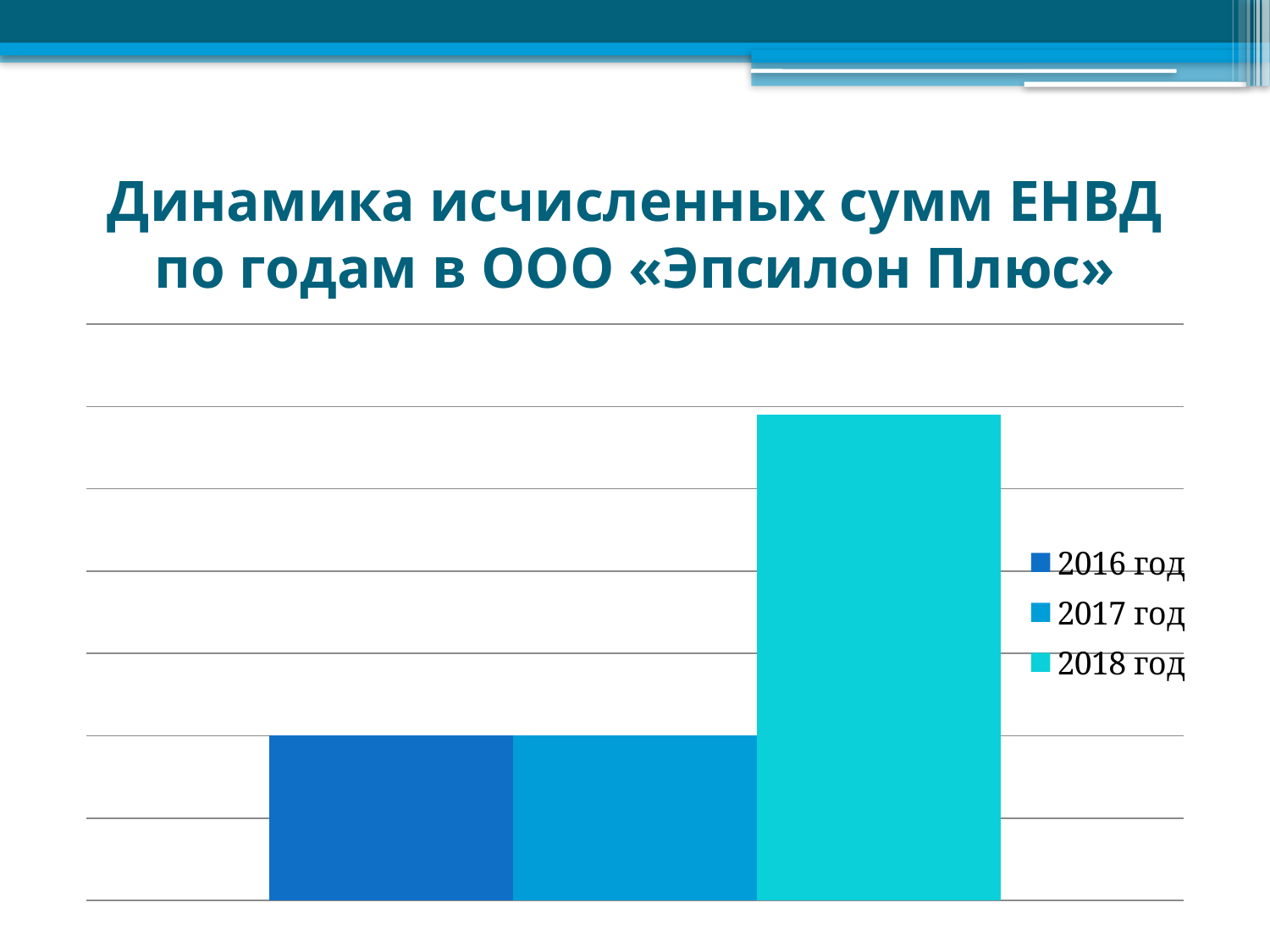
Which is larger, the value for 2017 год or the value for 2018 год? 2018 год How many bars are plotted in the chart? 3 What is the title of the slide containing the chart? Динамика исчисленных сумм ЕНВД по годам в ООО «Эпсилон Плюс» What kind of chart is shown on the slide? bar chart Do the values rise or fall from 2016 to 2018? rise How many series does the legend list? 3 Which is larger, the value for 2018 год or the value for 2016 год? 2018 год Which year has the highest bar in the chart? 2018 год Which legend entry is shown in the lightest (turquoise) colour? 2018 год